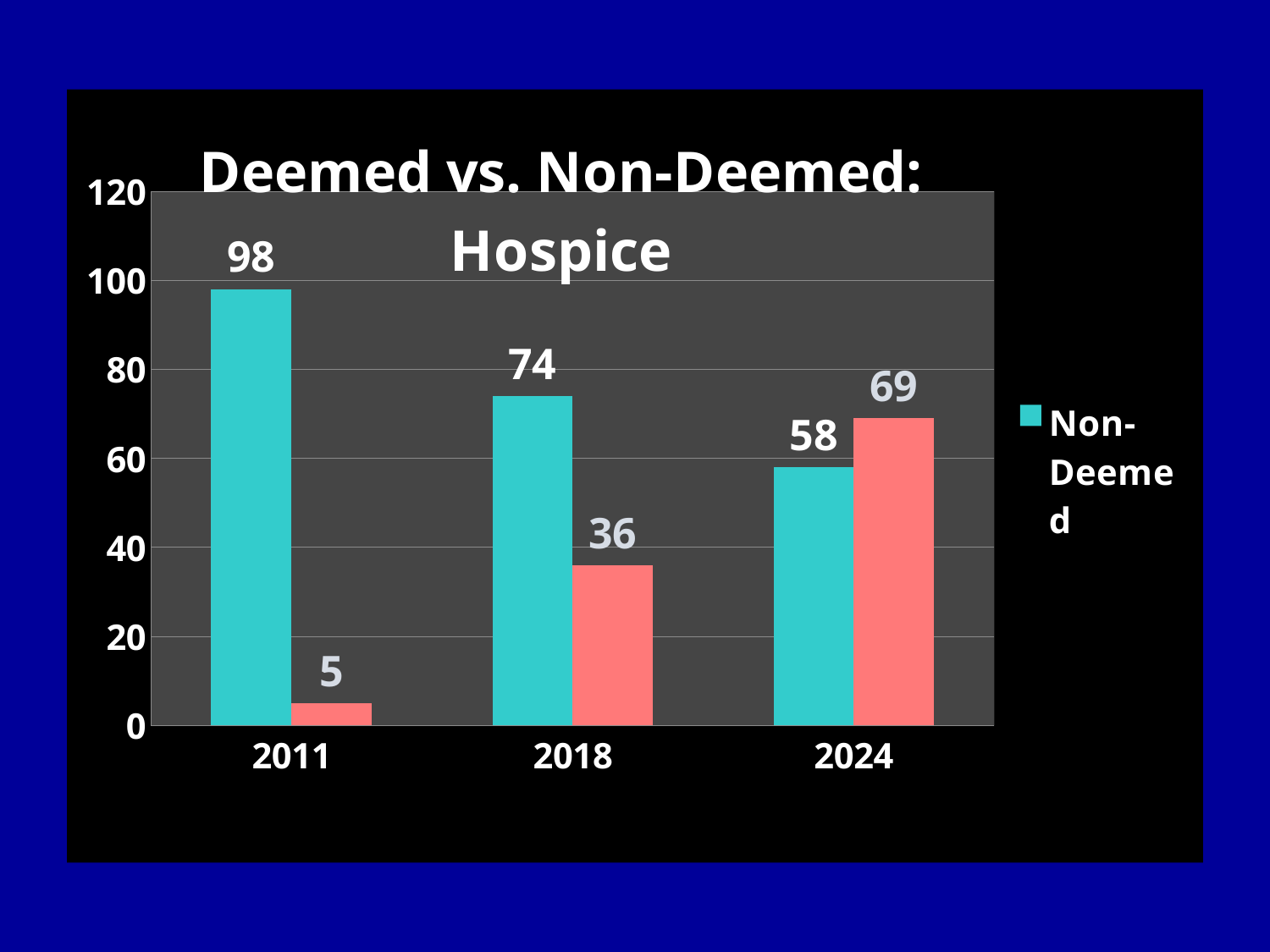
How many years are shown on the x axis? 3 What is the Non-Deemed value for 2024? 58 In 2024, which is larger: the Non-Deemed bar or the red bar? The red bar In which year is the red (coral) bar lowest? 2011 What is the Non-Deemed value for 2011? 98 What is the value of the red (coral) bar for 2024? 69 By how much does the red bar exceed the Non-Deemed bar in 2024? 11 Do the Non-Deemed values rise or fall from 2011 to 2024? Fall What is the difference between the Non-Deemed value and the red bar value in 2011? 93 What is the value of the red (coral) bar for 2018? 36 What kind of chart is shown on the slide? Bar chart In which year is the Non-Deemed value highest? 2011